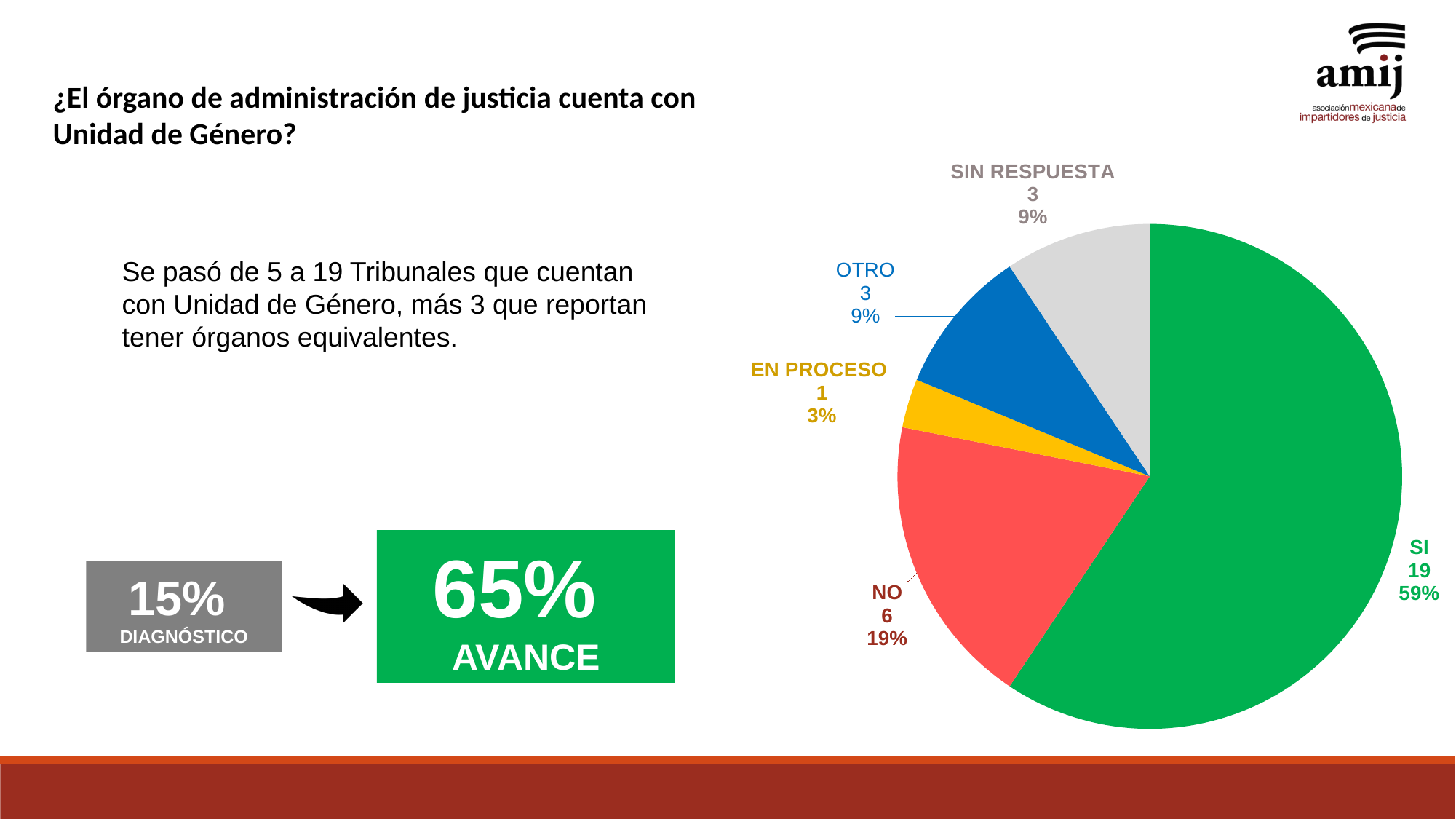
What kind of chart is shown on the slide? pie chart What percentage share does the SIN RESPUESTA slice have? 9% Which is larger, the count for NO or the count for OTRO? NO How many slices does the pie chart have? 5 What is the difference between the counts for SI and NO? 13 What colour is the SI slice of the pie? green What percentage share does the NO slice have? 19% What is the count shown for the EN PROCESO slice? 1 What is the total count across all slices of the pie? 32 What is the count shown for the SI slice? 19 Which category has the smallest slice of the pie? EN PROCESO Which category has the largest slice of the pie? SI